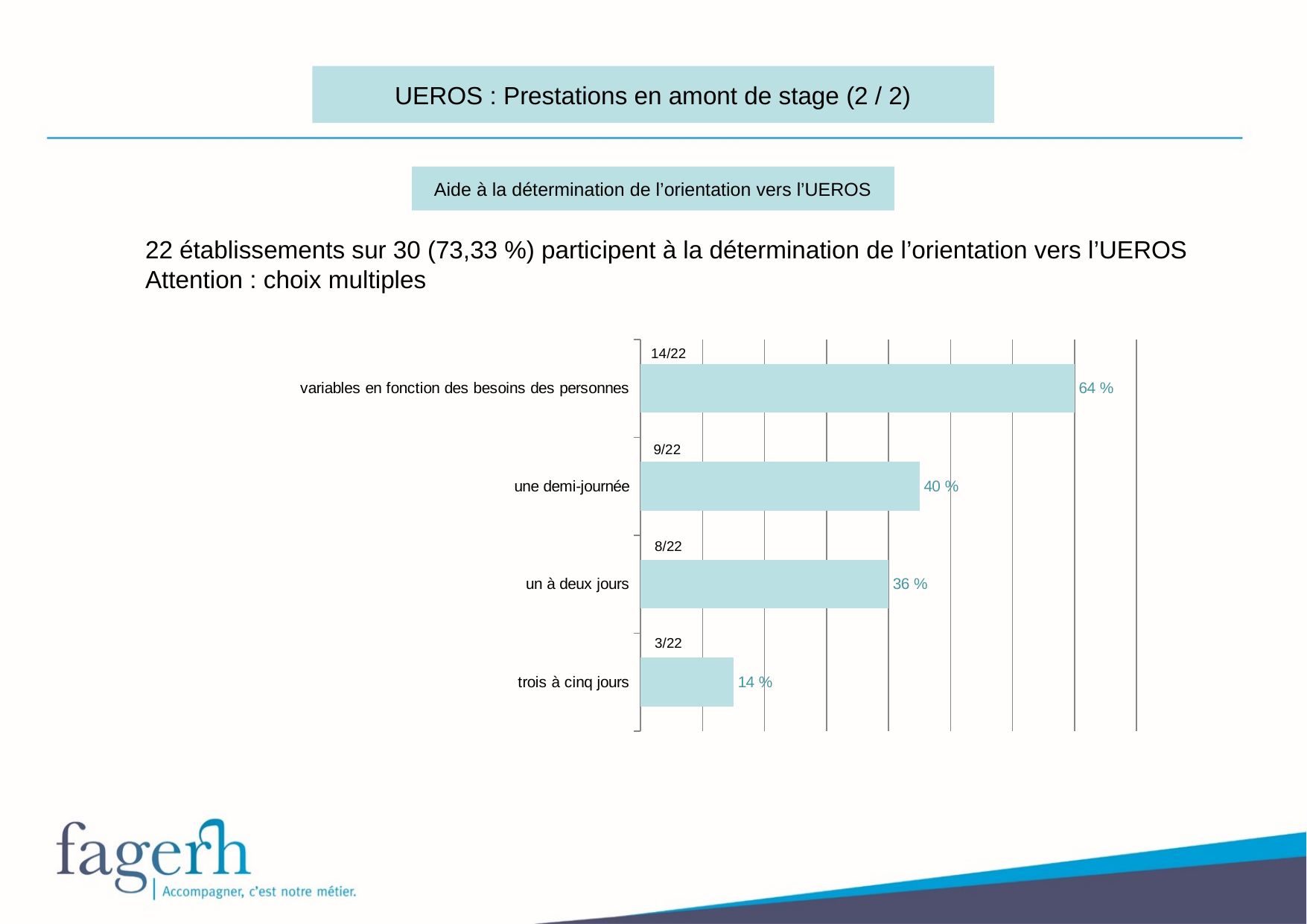
What percentage is shown for "trois à cinq jours"? 14 % How many categories are shown in the chart? 4 What percentage is shown for "une demi-journée"? 40 % Which category has the lowest percentage? trois à cinq jours What fraction label is shown for "un à deux jours"? 8/22 What fraction label is shown for "variables en fonction des besoins des personnes"? 14/22 Which category has the highest percentage? variables en fonction des besoins des personnes What kind of chart is shown on the slide? bar chart What is the difference in percentage points between "variables en fonction des besoins des personnes" and "une demi-journée"? 24 What is the difference in percentage points between "un à deux jours" and "trois à cinq jours"? 22 Which has a higher percentage, "une demi-journée" or "un à deux jours"? une demi-journée According to the text above the chart, how many establishments out of 30 participate in determining orientation towards UEROS? 22